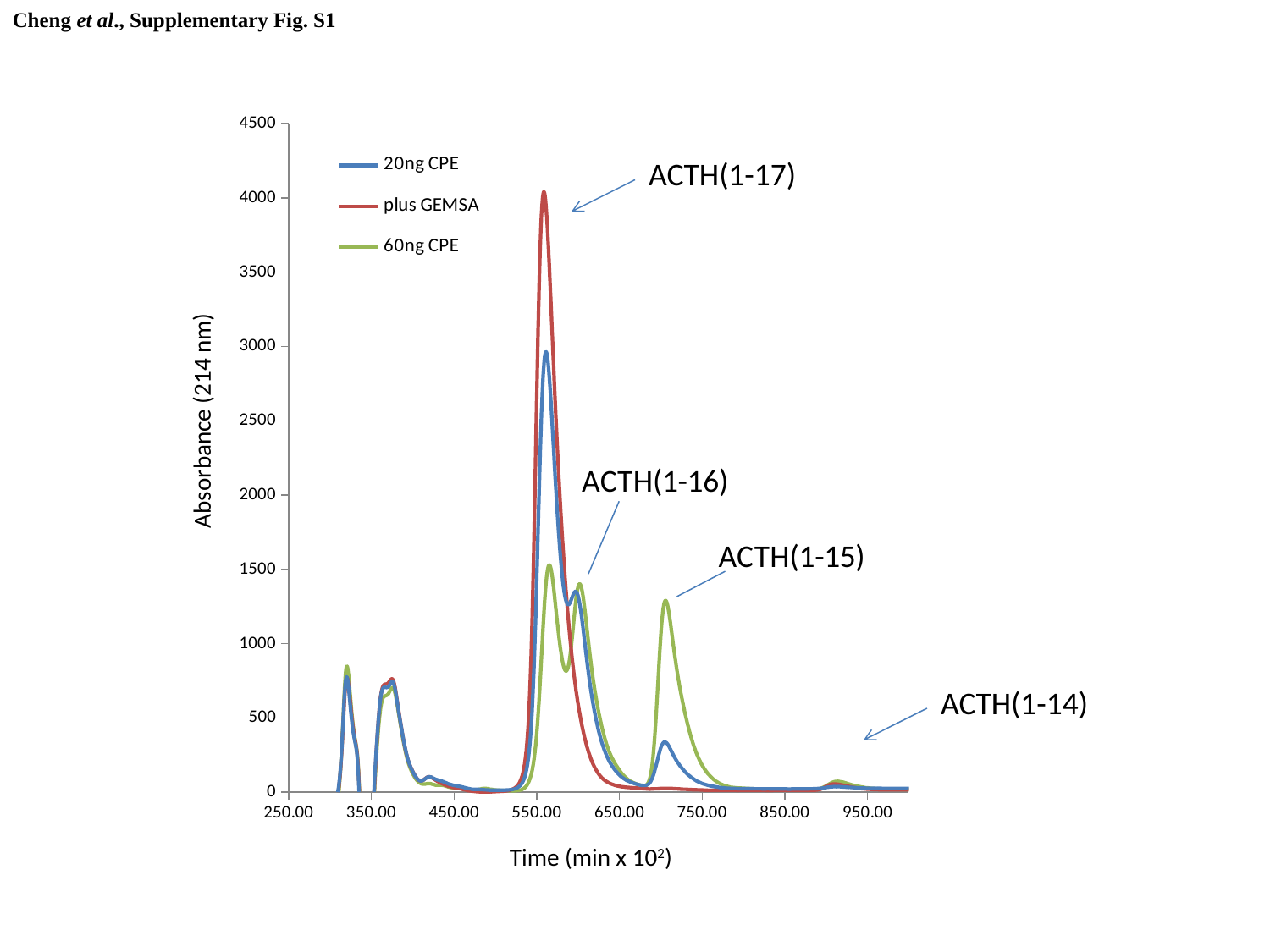
Which series has the highest peak at the ACTH(1-15) position? 60ng CPE How many series does the legend list? 3 What is the label of the y axis? Absorbance (214 nm) Which series has the highest peak at the ACTH(1-17) position? plus GEMSA Is the peak absorbance of the 60ng CPE series at ACTH(1-17) greater or less than 2000? less At the ACTH(1-17) peak, which series has the larger absorbance, 20ng CPE or 60ng CPE? 20ng CPE What kind of chart is shown on the slide? line chart Is the peak absorbance of the 60ng CPE series at ACTH(1-15) greater or less than 1000? greater Which series is drawn in red according to the legend? plus GEMSA Is the peak absorbance of the 20ng CPE series at ACTH(1-17) greater or less than 2500? greater